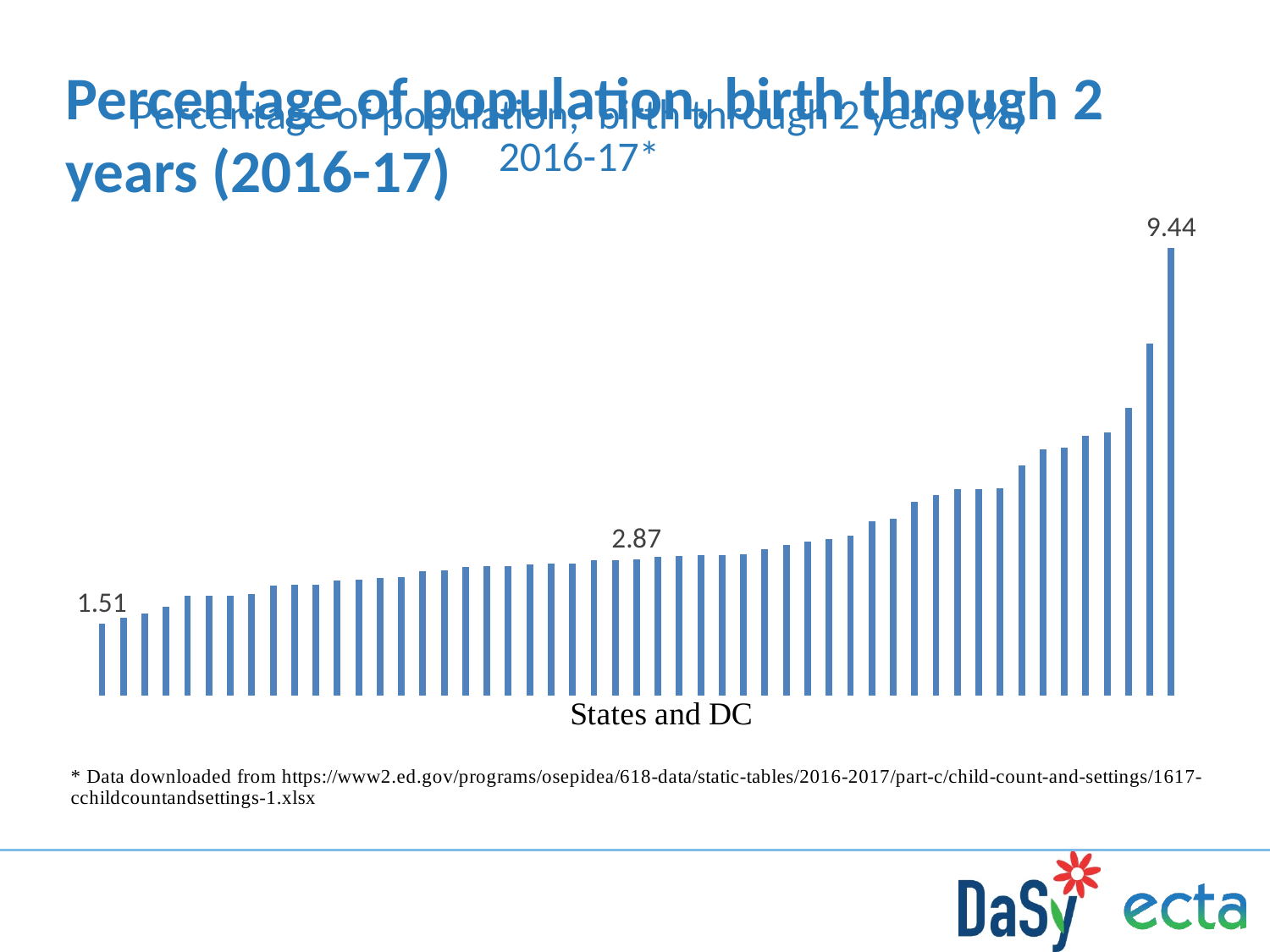
What is the highest value labeled on the chart? 9.44 What kind of chart is shown on the slide? bar chart How many bars are plotted on the chart? 51 Which is larger, the value labeled 2.87 or the value labeled 1.51? 2.87 What year range does the chart title refer to? 2016-17 Do the bar values rise or fall from left to right along the x axis? rise What is the label on the x axis of the chart? States and DC What is the difference between the highest labeled value (9.44) and the lowest labeled value (1.51)? 7.93 What is the lowest value labeled on the chart? 1.51 What value is labeled on the middle bar of the chart? 2.87 What is the difference between the middle labeled value (2.87) and the lowest labeled value (1.51)? 1.36